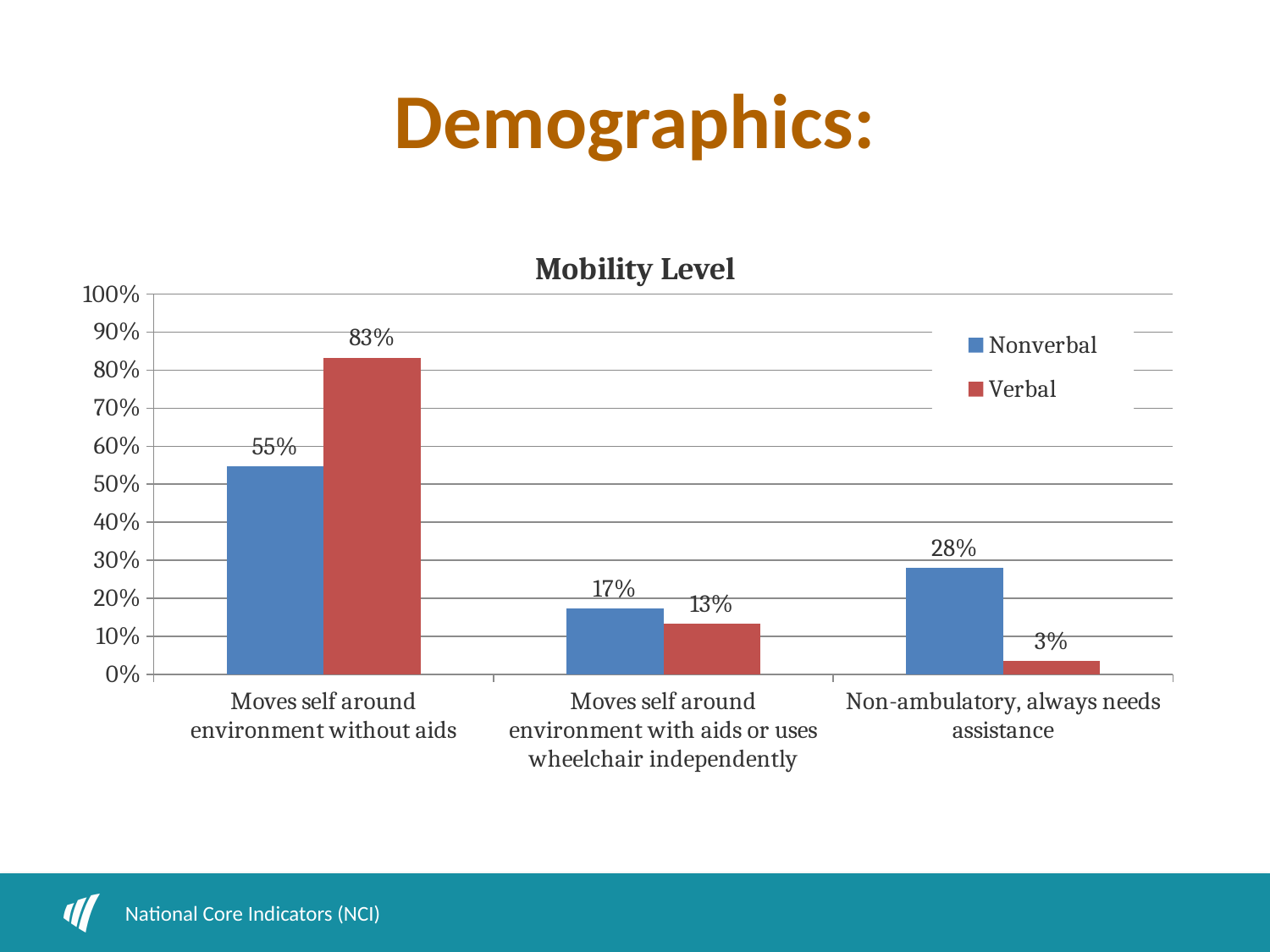
What is the Nonverbal value for "Moves self around environment without aids"? 55% How many mobility level categories are shown on the x axis? 3 What kind of chart is shown on the slide? Bar chart What is the Verbal value for "Non-ambulatory, always needs assistance"? 3% Which mobility level has the highest Verbal value? Moves self around environment without aids What is the Nonverbal value for "Moves self around environment with aids or uses wheelchair independently"? 17% What is the Verbal value for "Moves self around environment without aids"? 83% What is the title of the chart? Mobility Level For "Non-ambulatory, always needs assistance", which series has the larger value, Nonverbal or Verbal? Nonverbal What is the difference between the Verbal and Nonverbal values for "Moves self around environment without aids"? 28% Which mobility level has the lowest Nonverbal value? Moves self around environment with aids or uses wheelchair independently How many series does the legend list? 2